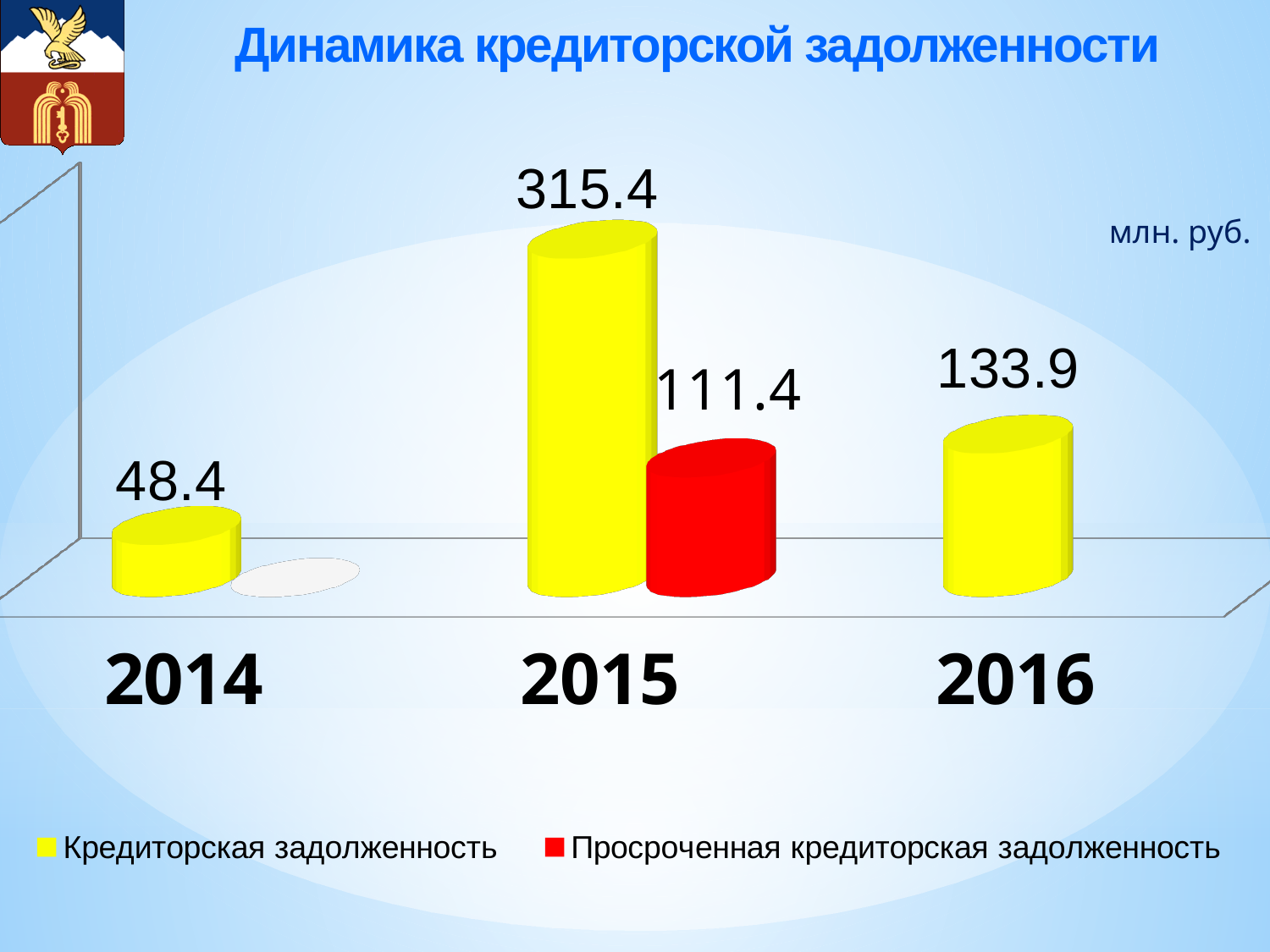
What is the value of Просроченная кредиторская задолженность for 2015? 111.4 What is the difference between Кредиторская задолженность in 2015 and 2016? 181.5 In which year is Кредиторская задолженность lowest? 2014 In which year is Кредиторская задолженность highest? 2015 How many series does the legend list? 2 How many years are shown on the x axis? 3 Which is larger in 2015: Кредиторская задолженность or Просроченная кредиторская задолженность? Кредиторская задолженность What is the value of Кредиторская задолженность for 2015? 315.4 What is the value of Кредиторская задолженность for 2014? 48.4 What kind of chart is shown on the slide? Bar chart What is the value of Кредиторская задолженность for 2016? 133.9 What is the difference between Кредиторская задолженность in 2016 and 2014? 85.5